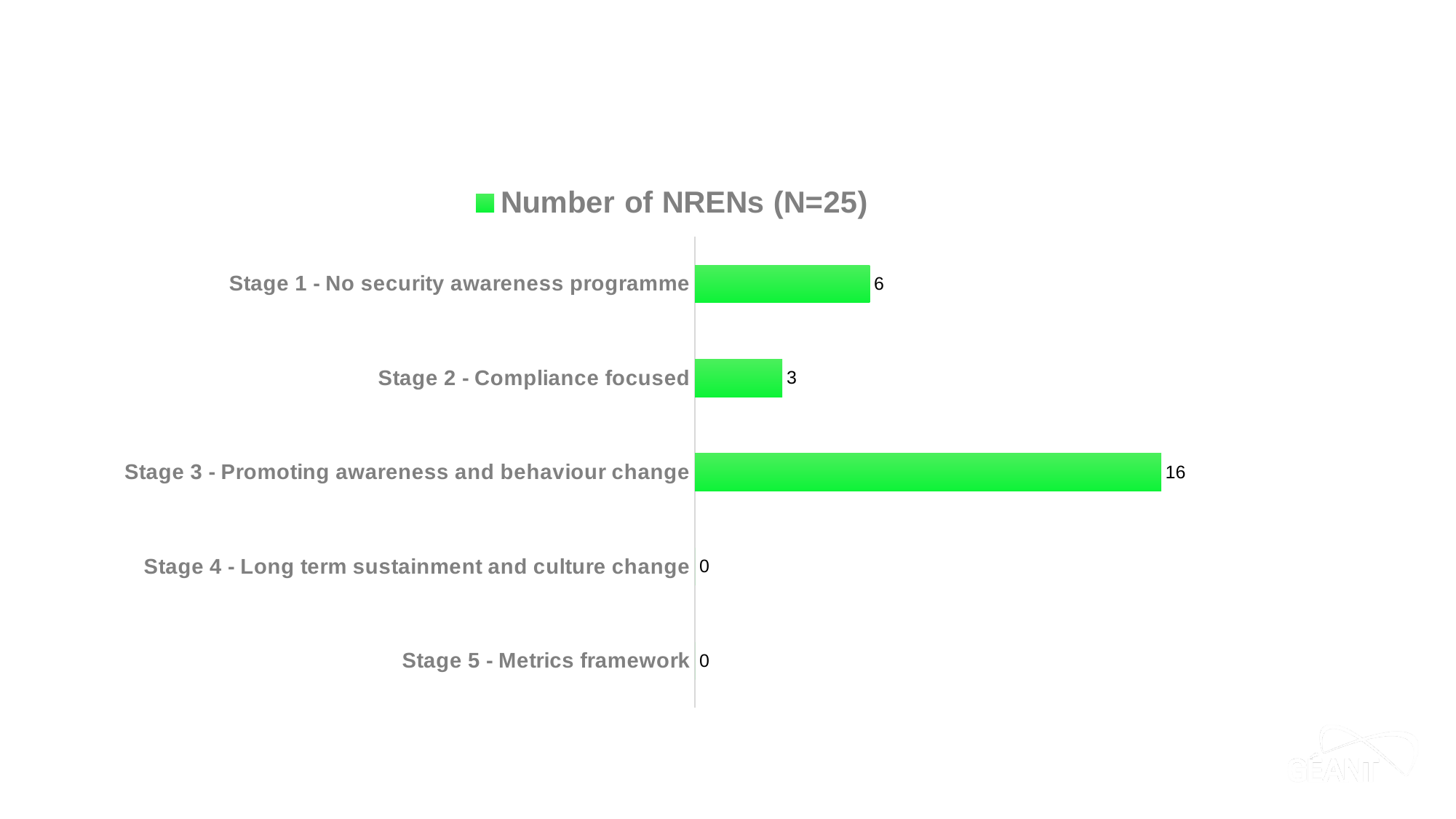
What is the value for Stage 2 - Compliance focused? 3 Which stage has the highest number of NRENs? Stage 3 - Promoting awareness and behaviour change What is the value for Stage 4 - Long term sustainment and culture change? 0 How many series does the legend list? 1 What is the value for Stage 3 - Promoting awareness and behaviour change? 16 How many stages (categories) are shown on the chart? 5 What is the value for Stage 1 - No security awareness programme? 6 What kind of chart is shown on the slide? Bar chart Which is larger, the value for Stage 1 or the value for Stage 2? Stage 1 What is the difference between the values for Stage 3 and Stage 1? 10 What is the legend entry shown above the chart? Number of NRENs (N=25) What is the difference between the values for Stage 1 and Stage 2? 3